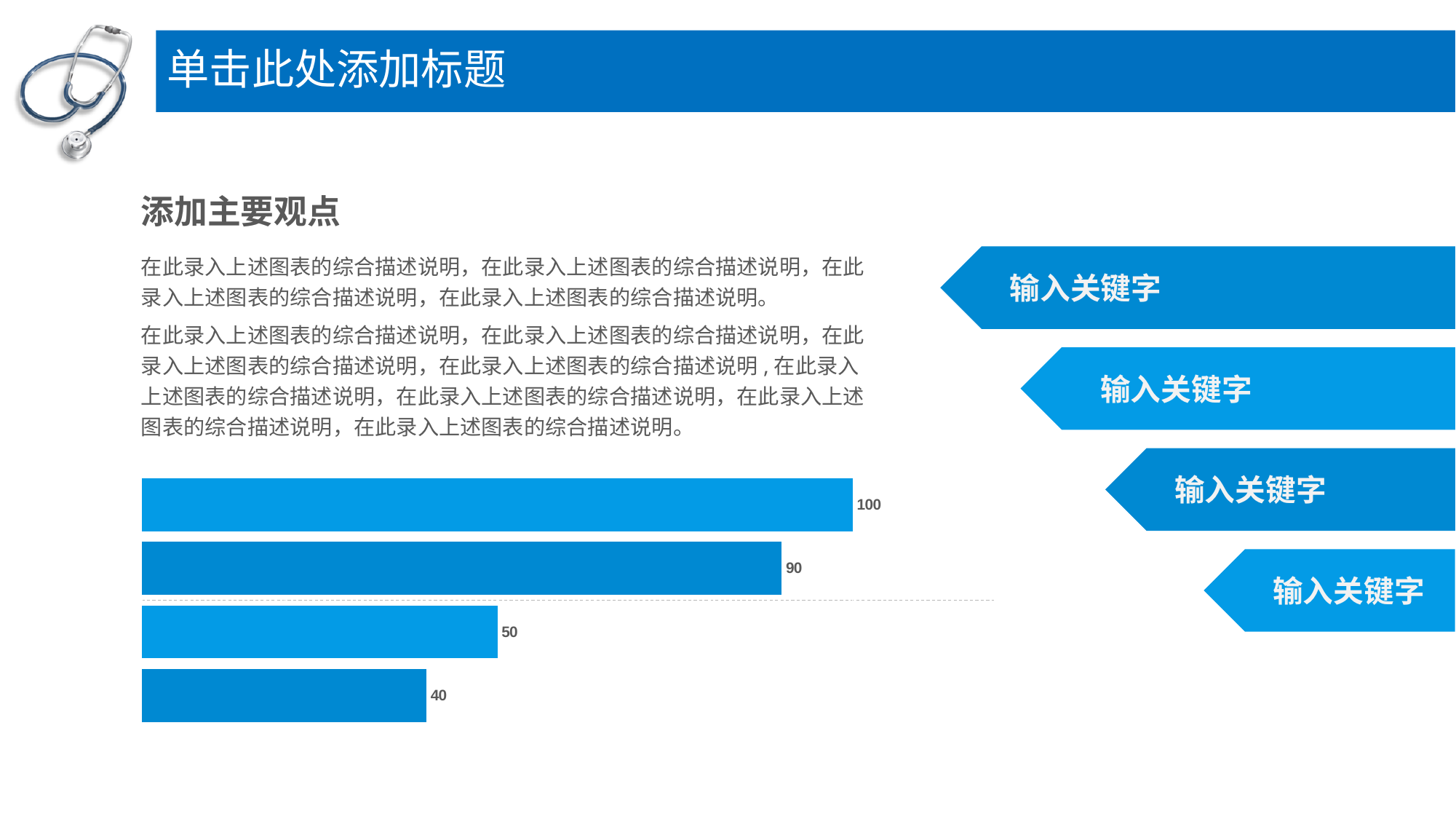
What is the difference between the top bar's value and the bottom bar's value? 60 What kind of chart is shown on the slide? bar chart How many bars does the chart contain? 4 What is the value of the second bar from the top in the chart? 90 What is the difference between the second bar's value and the third bar's value? 40 What is the value of the third bar from the top in the chart? 50 Do the bar values increase or decrease from the top bar to the bottom bar? decrease Which bar has the highest value in the chart? the top bar What is the value of the bottom bar in the chart? 40 Which bar has the lowest value in the chart? the bottom bar Which is larger, the value of the third bar from the top or the value of the bottom bar? the third bar from the top What is the value of the top bar in the chart? 100